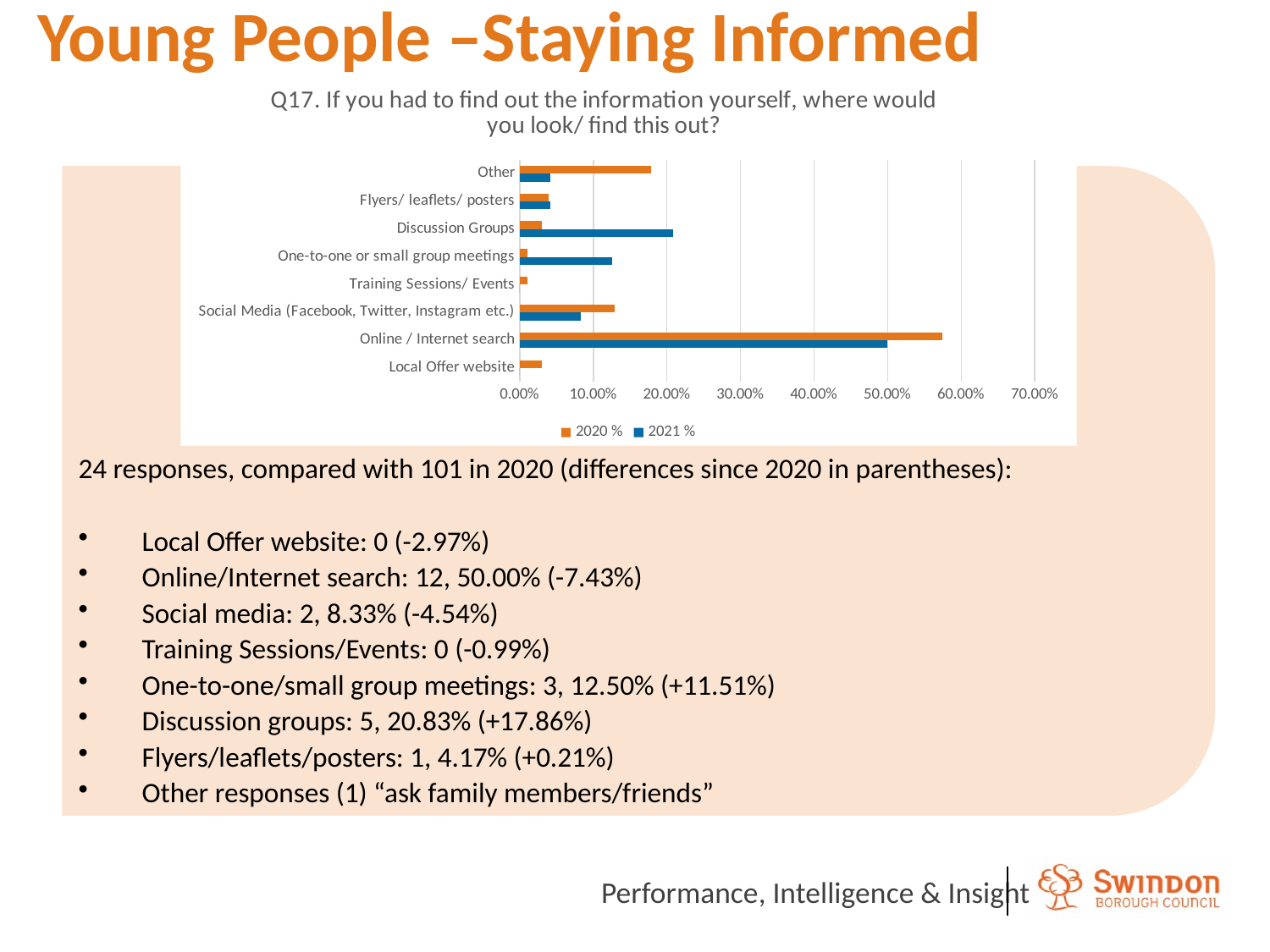
Is the 2021 % value for Discussion Groups greater or less than 10.00%? greater Is the 2020 % value for Online / Internet search greater or less than 50.00%? greater For the Other category, which series has the larger value, 2020 % or 2021 %? 2020 % What kind of chart is shown on the slide? bar chart Is the 2020 % value for Social Media (Facebook, Twitter, Instagram etc.) greater or less than 20.00%? less Which category has the highest value for the 2021 % series? Online / Internet search What is the 2021 % value for Online / Internet search? 50.00% How many series does the chart legend list? 2 What are the two series named in the chart legend? 2020 % and 2021 % Which category has the highest value for the 2020 % series? Online / Internet search How many categories are shown on the chart's vertical axis? 8 For Discussion Groups, which series has the larger value, 2020 % or 2021 %? 2021 %